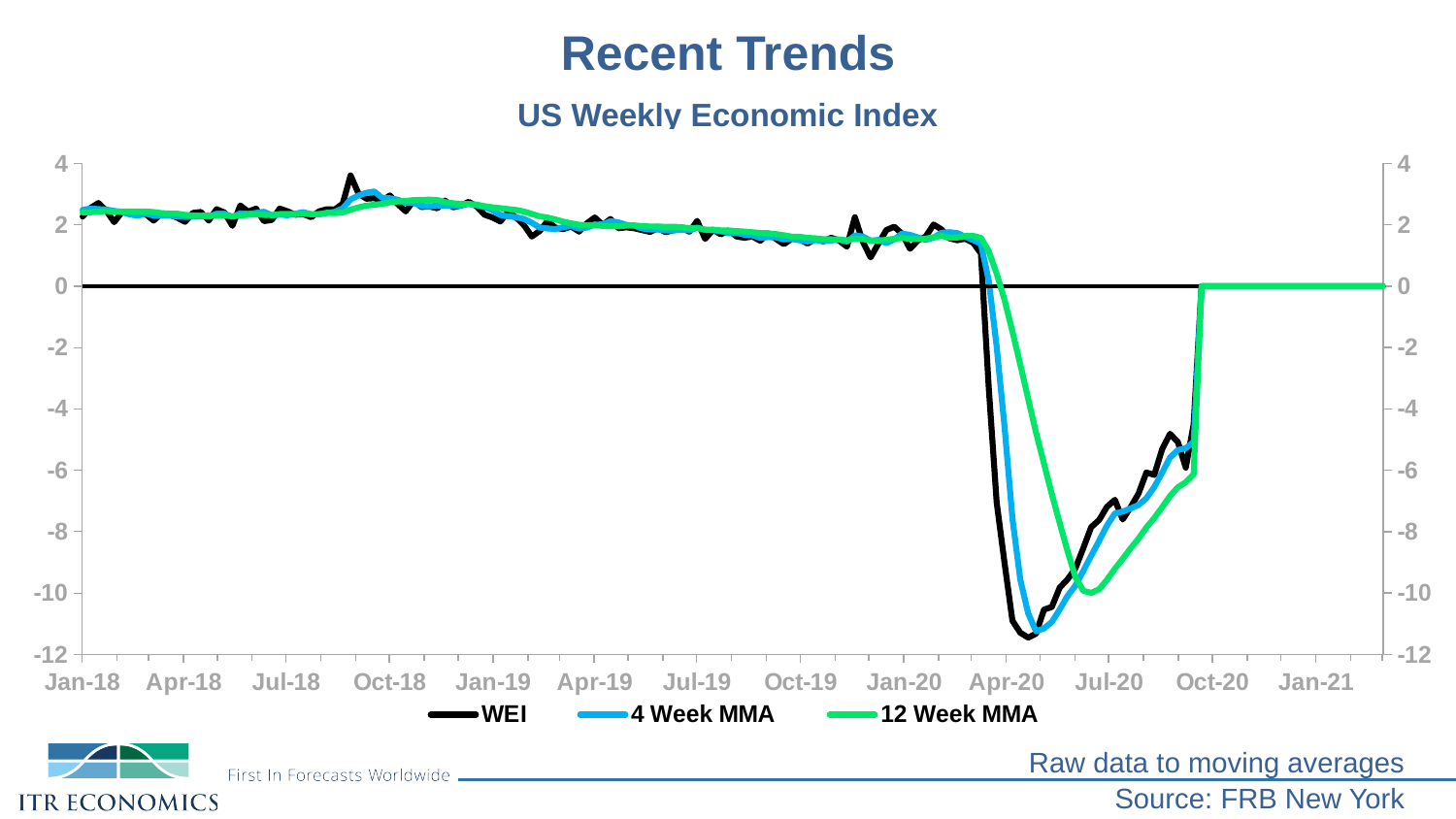
Is the lowest value of the WEI line around Apr-20 greater or less than -10? less Which colour is used for the 12 Week MMA line? Green Is the WEI value at Jan-20 greater or less than 2? less What is the title of the chart? US Weekly Economic Index Is the lowest value of the 4 Week MMA line greater or less than -10? less How many series does the legend list? 3 Do the values generally rise or fall between Jan-18 and Jan-20? Fall Do the values rise or fall between Apr-20 and Oct-20? Rise What kind of chart is shown on the slide? Line chart How many date labels are shown on the x axis? 13 Which reaches a lower minimum value, the WEI line or the 12 Week MMA line? WEI